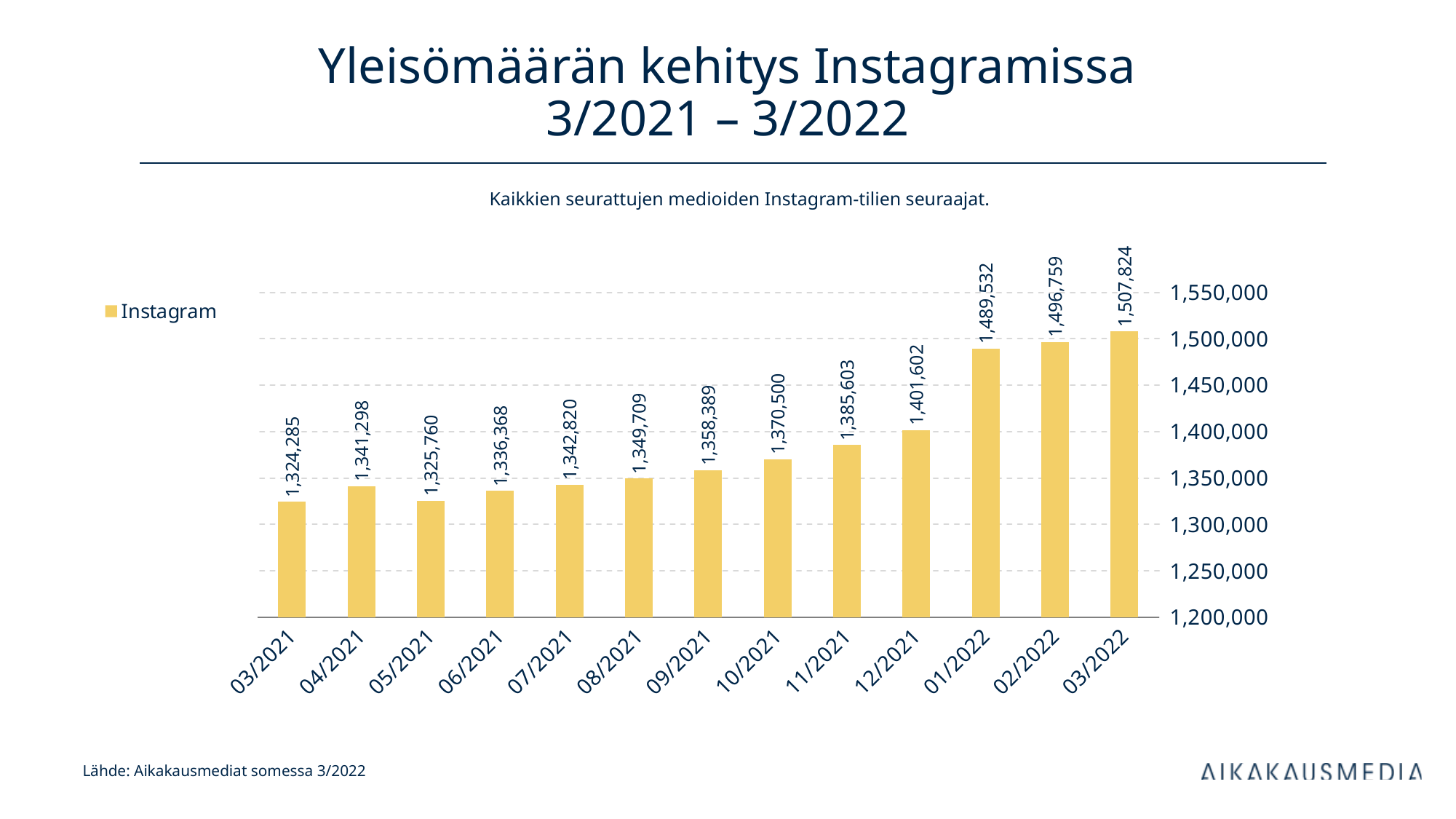
What is the value for 03/2021? 1,324,285 What is the difference between the values for 03/2022 and 03/2021? 183,539 Which month has the lowest value? 03/2021 What is the value for 09/2021? 1,358,389 Is the value for 12/2021 greater or less than 1,400,000? greater How many months are shown on the x axis? 13 Which is larger, the value for 04/2021 or the value for 05/2021? 04/2021 Which month has the highest value? 03/2022 What series name does the legend show? Instagram What kind of chart is shown on the slide? bar chart What is the value for 01/2022? 1,489,532 What is the difference between the values for 01/2022 and 12/2021? 87,930